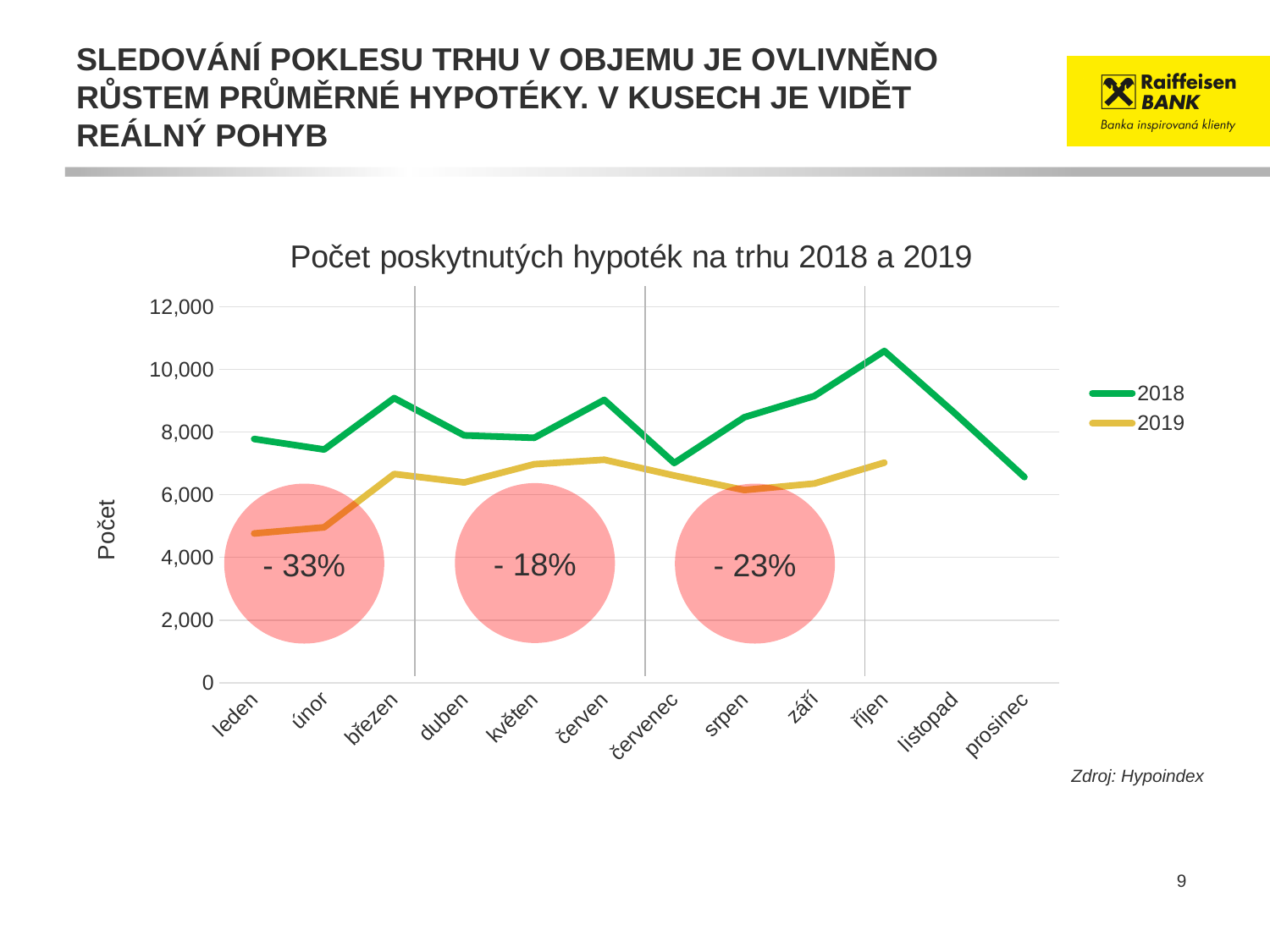
How many series does the legend list? 2 Is the 2018 value for prosinec greater or less than 8,000? less How many months are shown on the x axis? 12 Is the 2019 value for leden greater or less than 6,000? less In which month does the 2019 series have its lowest value? leden What is the title of the chart? Počet poskytnutých hypoték na trhu 2018 a 2019 What kind of chart is shown on the slide? line chart In which month does the 2018 series reach its highest value? říjen Which series has the larger value in březen, 2018 or 2019? 2018 Is the 2018 value for říjen greater or less than 10,000? greater Does the 2018 series rise or fall from říjen to prosinec? fall What percentage is shown in the middle red circle on the chart? - 18%